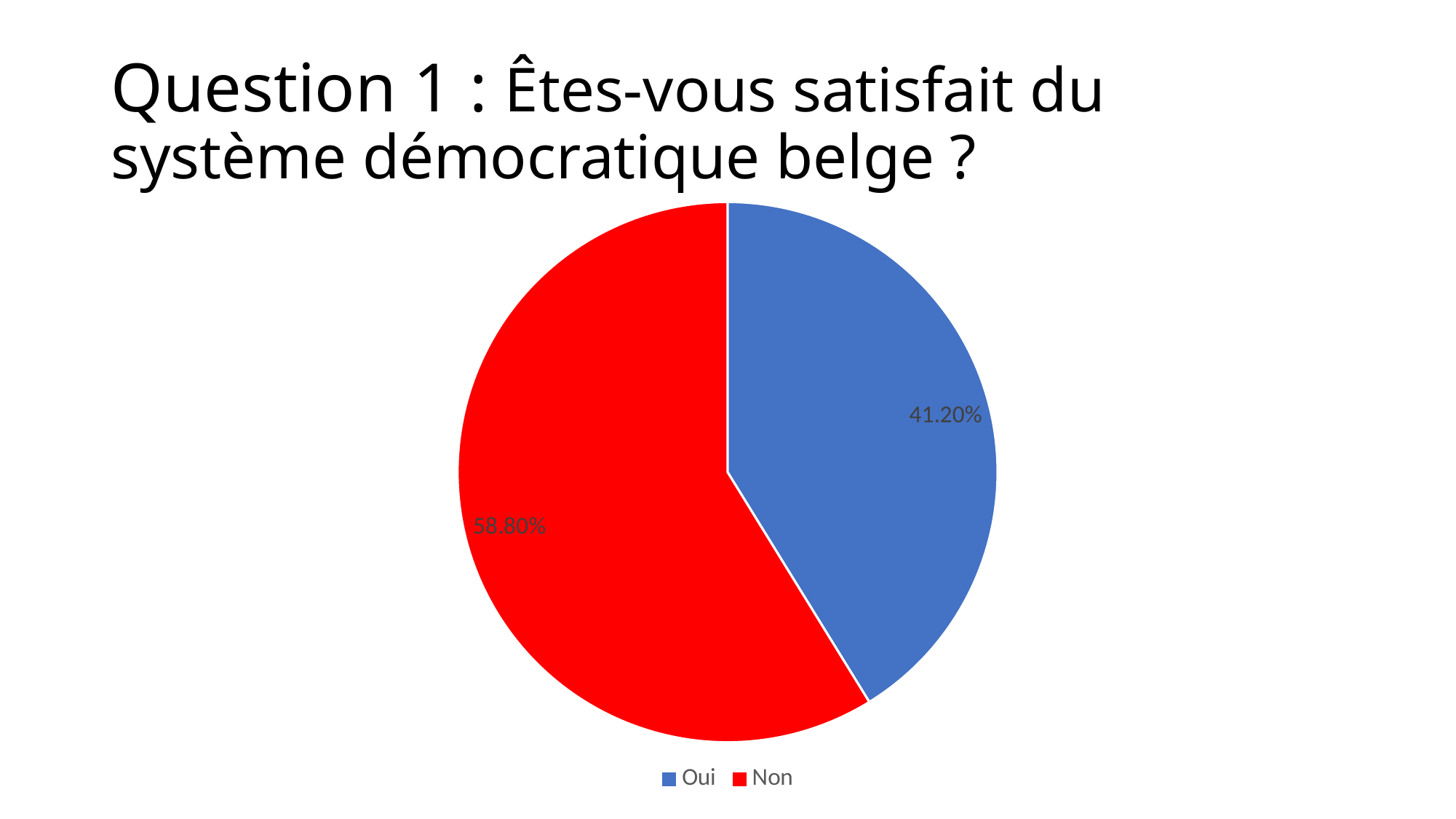
Which is larger, the "Oui" slice or the "Non" slice? Non What percentage of the pie is labelled for "Non"? 58.80% How many entries does the legend list? 2 What colour is the "Oui" slice? blue How many slices does the pie chart have? 2 What is the difference in percentage points between the "Non" slice and the "Oui" slice? 17.60% Which slice is the smallest? Oui What percentage of the pie is labelled for "Oui"? 41.20% What colour is the "Non" slice? red What kind of chart is shown on the slide? pie chart Which slice is the largest? Non What share of the pie does the "Non" slice represent? 58.80%